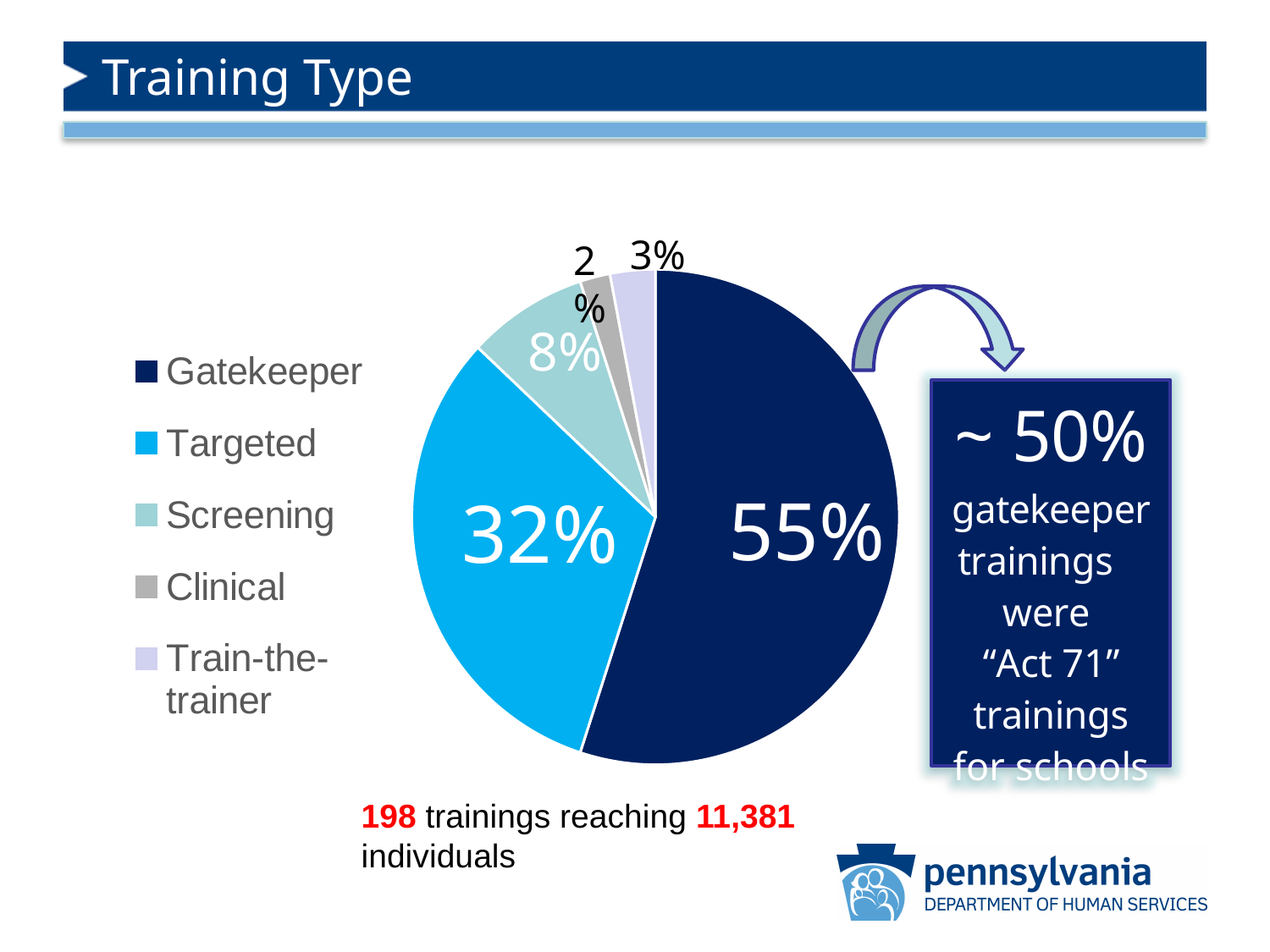
Which training type has the smallest share of the pie? Clinical What share of the pie does Gatekeeper represent? 55% Which has a larger share, Screening or Train-the-trainer? Screening What is the difference in percentage points between the Gatekeeper and Targeted shares? 23 What is the title of the slide containing the pie chart? Training Type How many training types are shown in the pie chart? 5 What type of chart is shown on the slide? pie chart What share of the pie does Train-the-trainer represent? 3% Which training type has the largest share of the pie? Gatekeeper What share of the pie does Clinical represent? 2%